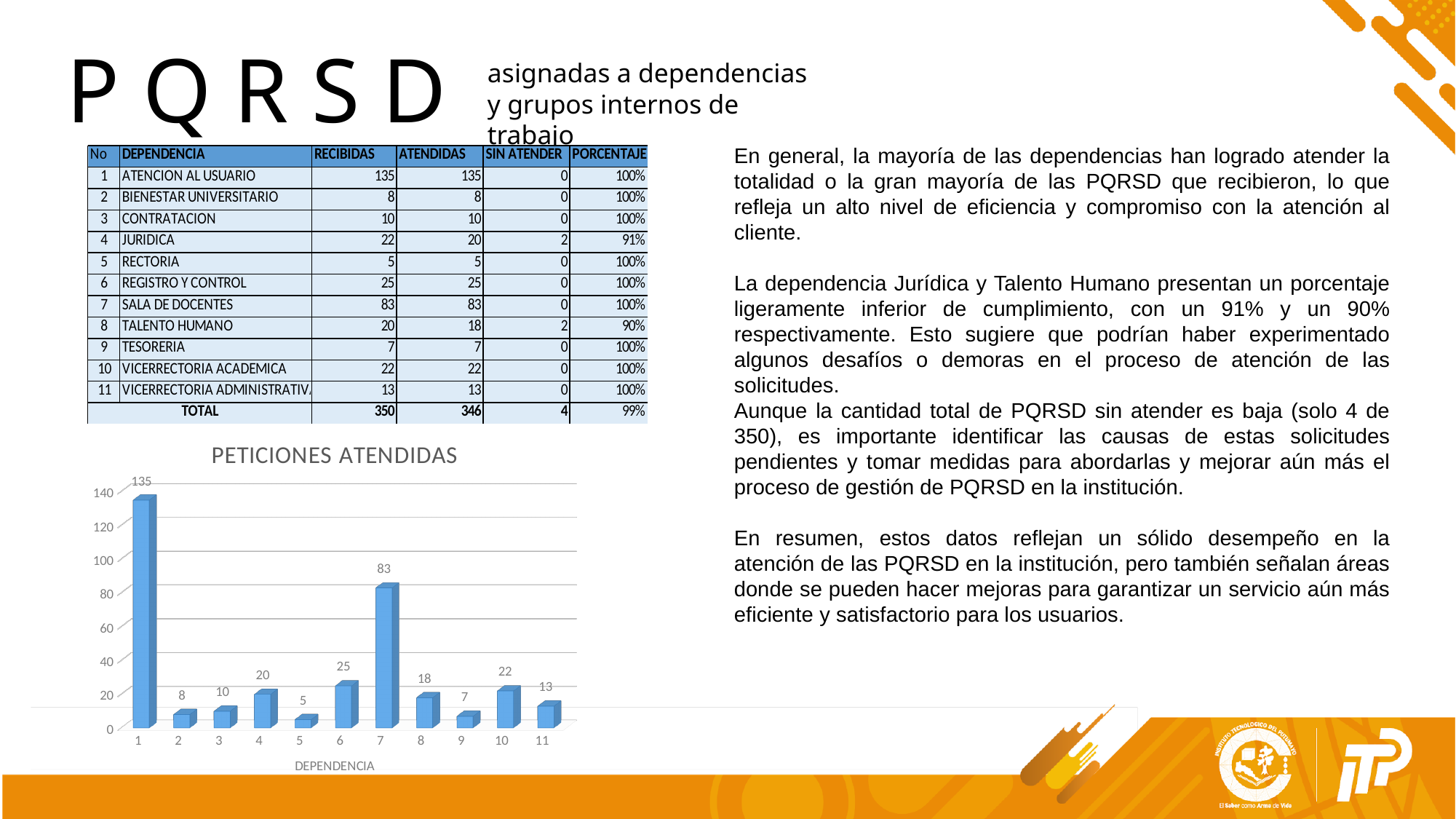
How many categories are plotted on the x axis of the chart? 11 What is the x axis title of the chart? DEPENDENCIA What is the value for category 6 in the chart? 25 What is the difference between the values for category 1 and category 7? 52 Which category has the highest value in the chart? 1 Which category has the lowest value in the chart? 5 What is the value for category 1 in the chart? 135 Which has a larger value, category 4 or category 10? 10 What type of chart is shown on the slide? bar chart What is the title of the chart on the slide? PETICIONES ATENDIDAS What is the value for category 7 in the chart? 83 Is the value for category 7 greater or less than 80? greater